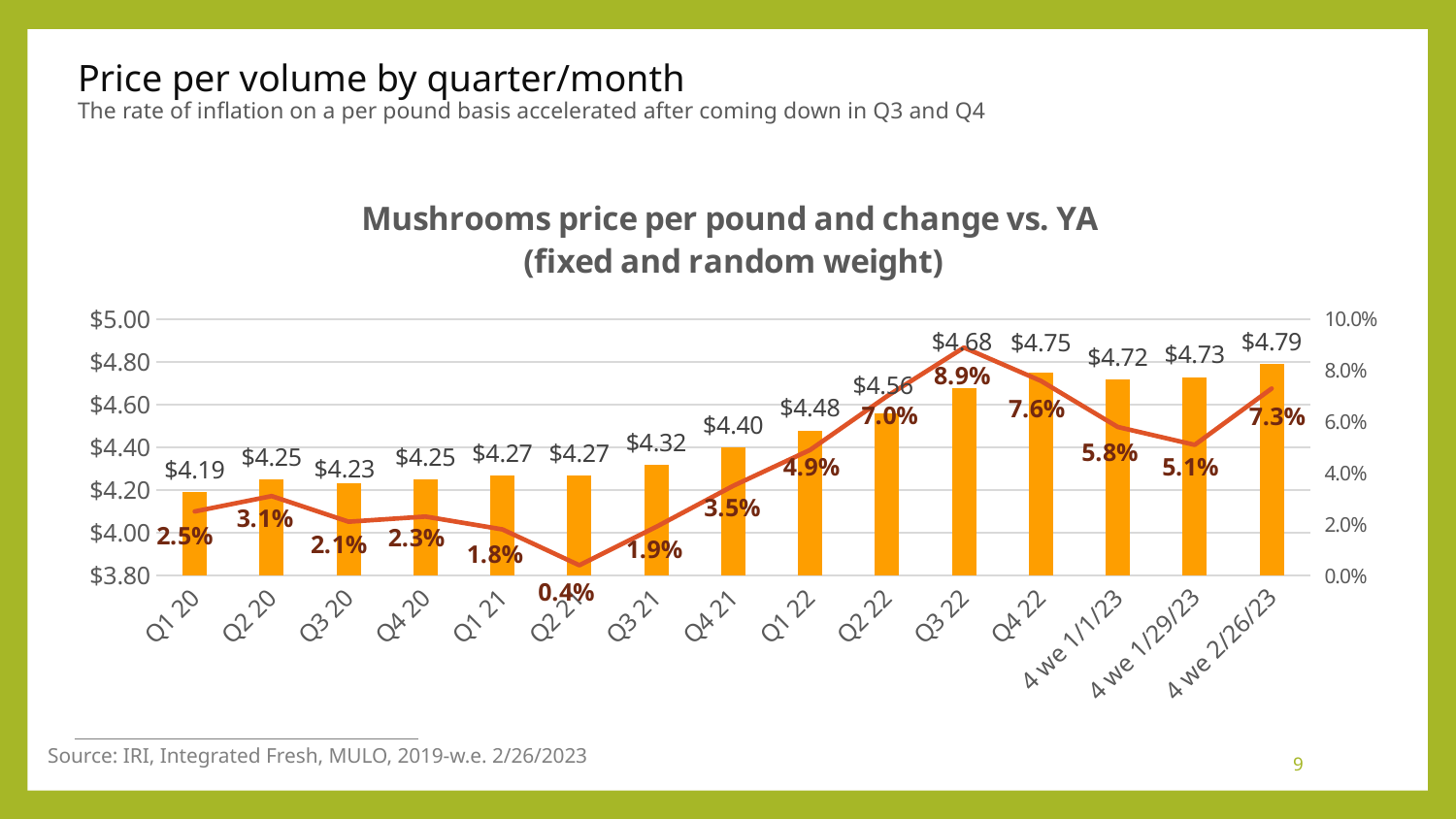
What is the title of the chart? Mushrooms price per pound and change vs. YA (fixed and random weight) What kind of chart is this? Combination bar and line chart Which period has the highest price per pound? 4 we 2/26/23 Which has the higher price per pound, Q3 20 or Q4 20? Q4 20 What is the difference between the price per pound in Q4 22 and in Q1 20? $0.56 What is the change vs. YA shown for Q3 22? 8.9% What is the mushrooms price per pound for Q1 20? $4.19 How many periods are shown on the x axis? 15 By how many percentage points did the change vs. YA fall from Q3 22 to Q4 22? 1.3% Does the price per pound generally rise or fall from Q1 20 to Q4 22? Rise What is the change vs. YA shown for 4 we 1/29/23? 5.1% Which period has the lowest change vs. YA? Q2 21